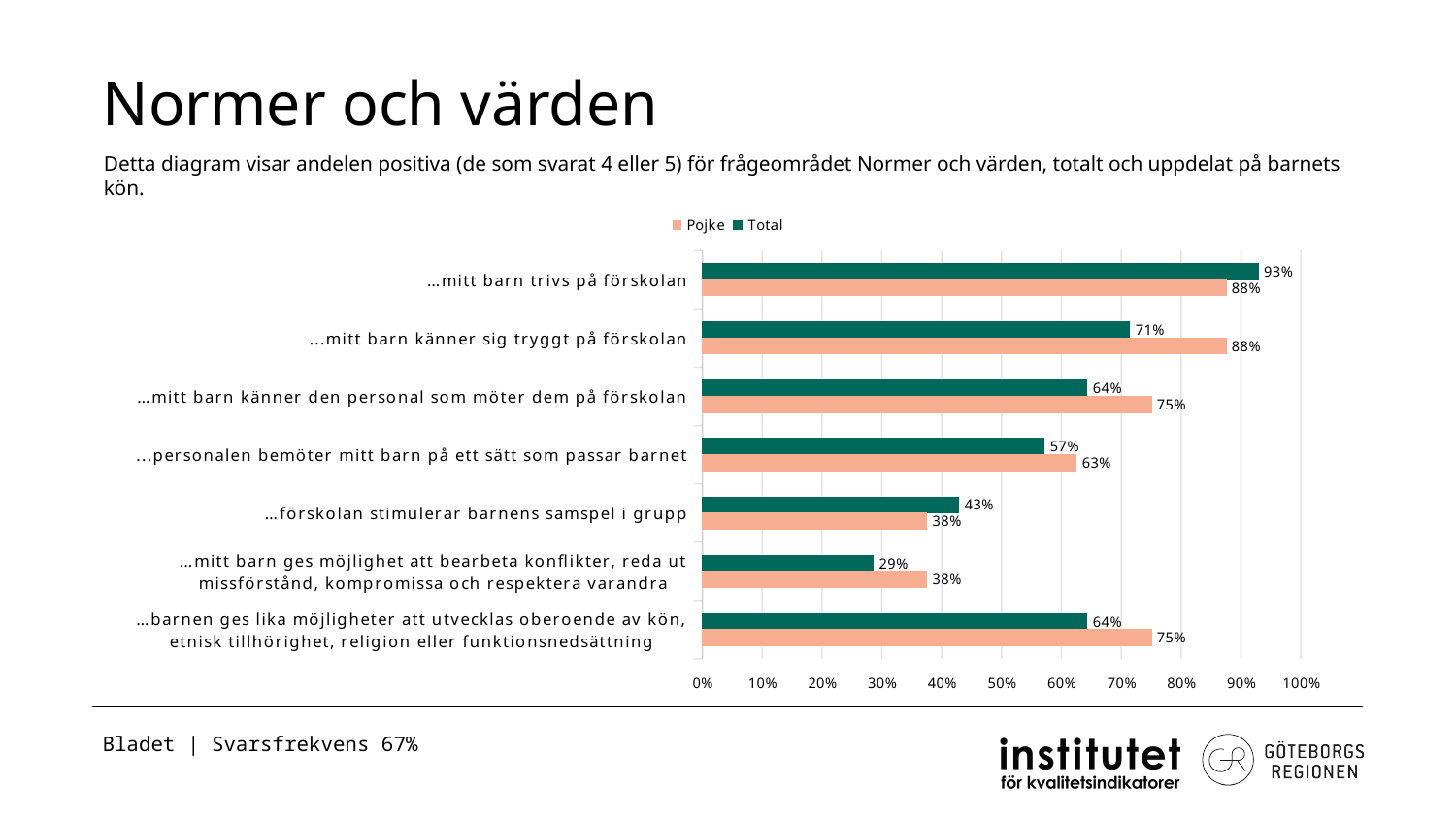
For "…förskolan stimulerar barnens samspel i grupp", which is larger, the Pojke value or the Total value? Total How many categories are shown in the chart? 7 Which category has the lowest Total value? …mitt barn ges möjlighet att bearbeta konflikter, reda ut missförstånd, kompromissa och respektera varandra What is the difference between the Pojke and Total values for "...mitt barn känner sig tryggt på förskolan"? 17% Which category has the highest Total value? …mitt barn trivs på förskolan Is the Pojke value for "...personalen bemöter mitt barn på ett sätt som passar barnet" greater or less than 50%? greater Which series is shown in dark green in the legend? Total What is the Total value for "…mitt barn trivs på förskolan"? 93% What is the Pojke value for "...mitt barn känner sig tryggt på förskolan"? 88% How many series does the legend list? 2 What kind of chart is shown on the slide? Bar chart What is the Total value for "…mitt barn ges möjlighet att bearbeta konflikter, reda ut missförstånd, kompromissa och respektera varandra"? 29%